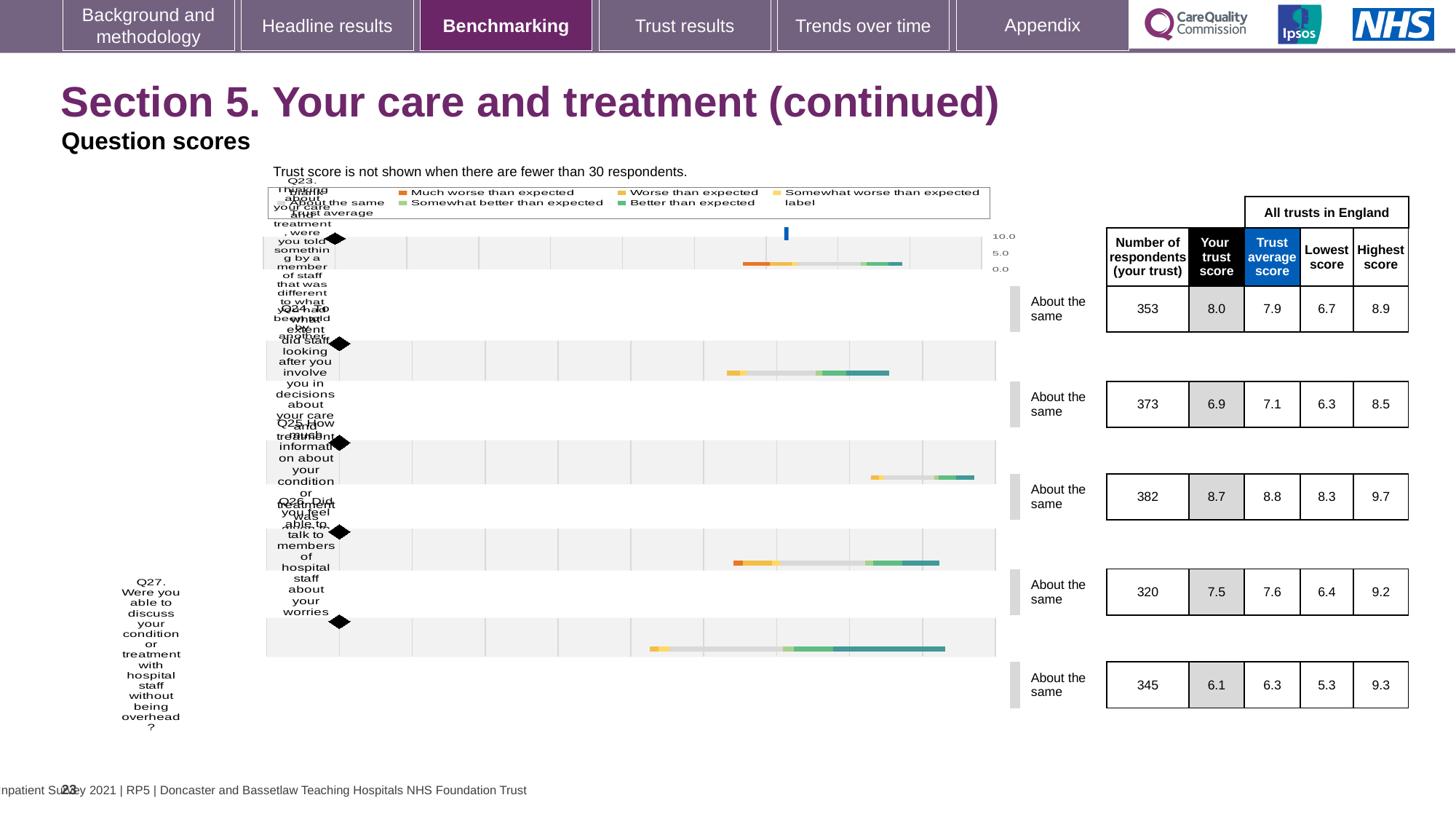
What is the trust average score for Q25? 8.8 How many respondents (your trust) are shown for Q23? 353 What kind of chart is used to show the question scores? Bar chart Which question has the lowest 'Your trust score'? Q27 What is the 'Your trust score' for Q24? 6.9 What is the highest score among all trusts in England for Q27? 9.3 What benchmark category is shown next to each question's bar? About the same Which question has the highest 'Your trust score'? Q25 Which has the larger 'Your trust score', Q23 or Q24? Q23 What is the difference between the trust average score and 'Your trust score' for Q27? 0.2 How many questions are plotted on the chart? 5 What is the lowest score among all trusts in England for Q26? 6.4